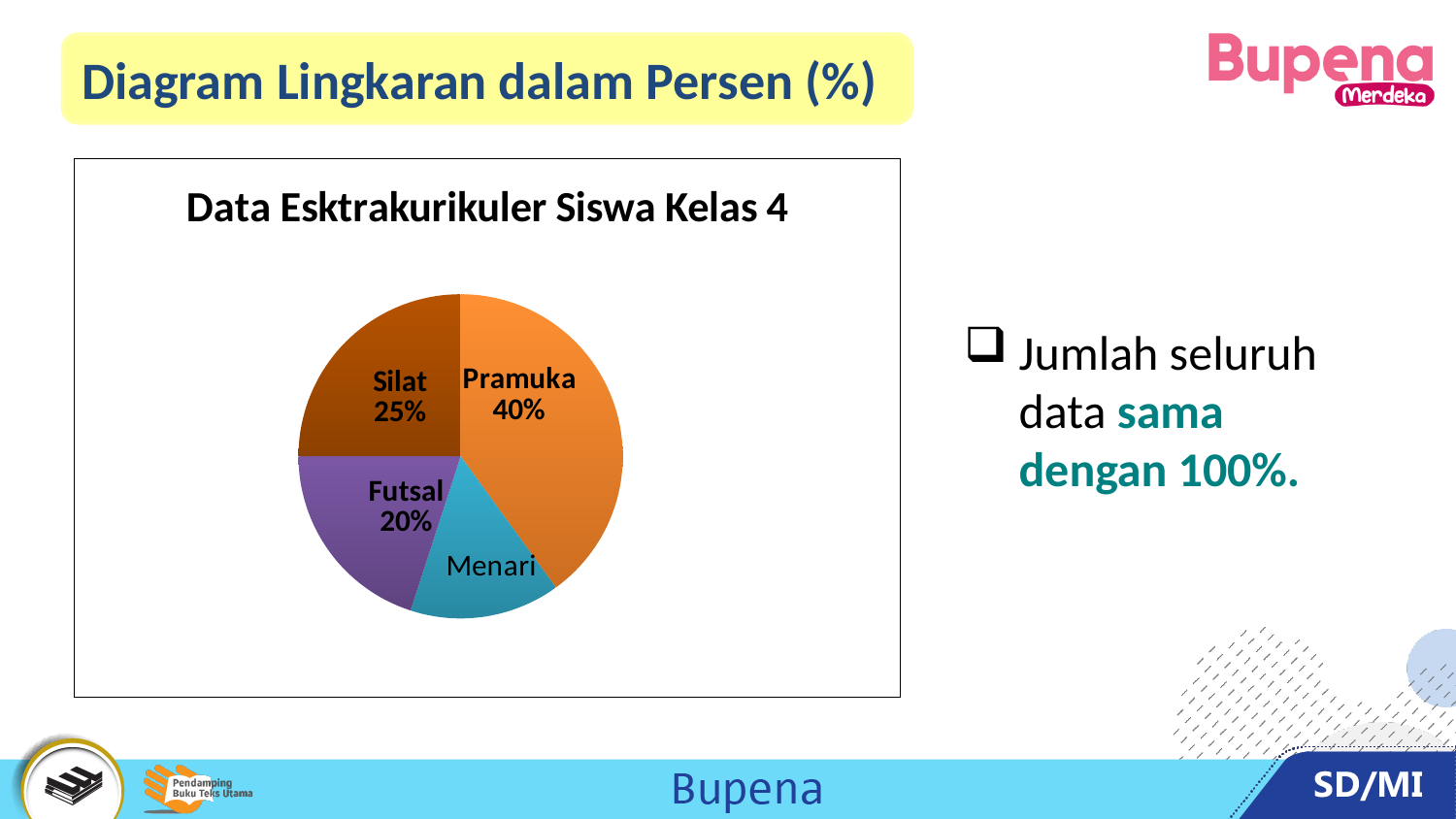
What percentage of the pie chart is Silat? 25% What percentage of the pie chart is Futsal? 20% What is the difference in percentage points between Pramuka and Futsal? 20% What percentage of the pie chart is Pramuka? 40% Which is larger, the slice for Pramuka or the slice for Silat? Pramuka Which is larger, the slice for Silat or the slice for Futsal? Silat What is the difference in percentage points between Pramuka and Silat? 15% What is the title of the chart? Data Esktrakurikuler Siswa Kelas 4 What is the difference in percentage points between Silat and Futsal? 5% Which extracurricular activity has the largest slice of the pie chart? Pramuka How many slices does the pie chart have? 4 What kind of chart is shown on the slide? Pie chart